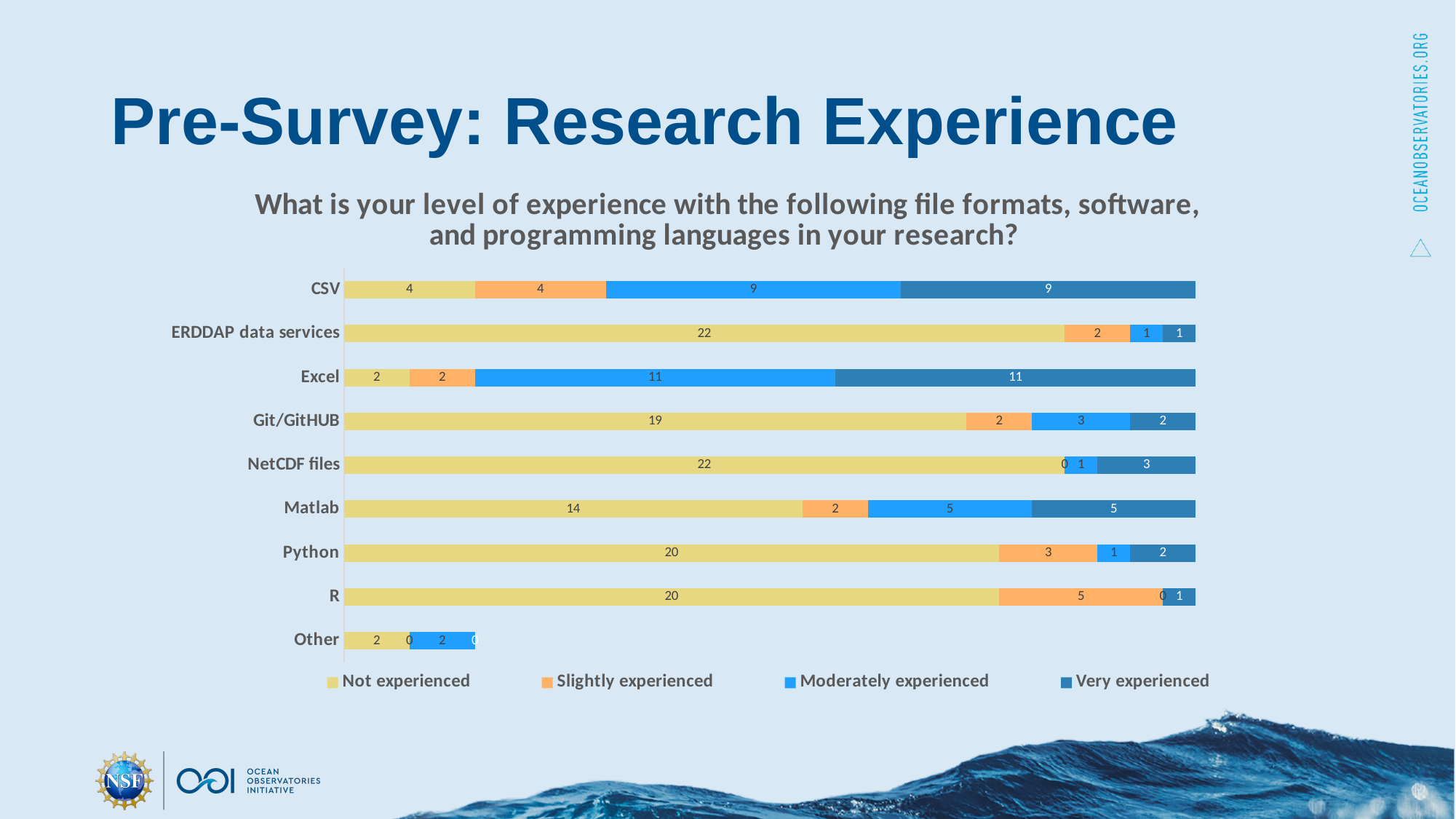
What is the 'Slightly experienced' value for R? 5 How many series does the legend list? 4 What type of chart is shown on the slide? Stacked bar chart Which category has the highest 'Very experienced' value? Excel How many categories are plotted on the chart? 9 Which category has the lowest 'Not experienced' value? Excel and Other (both 2) What is the 'Moderately experienced' value for Matlab? 5 What is the 'Not experienced' value for ERDDAP data services? 22 What is the 'Very experienced' value for Excel? 11 Which is larger, the 'Very experienced' value for CSV or for Matlab? CSV What is the difference between the 'Not experienced' values for Git/GitHUB and Matlab? 5 What is the total of the stacked bar for Python? 26